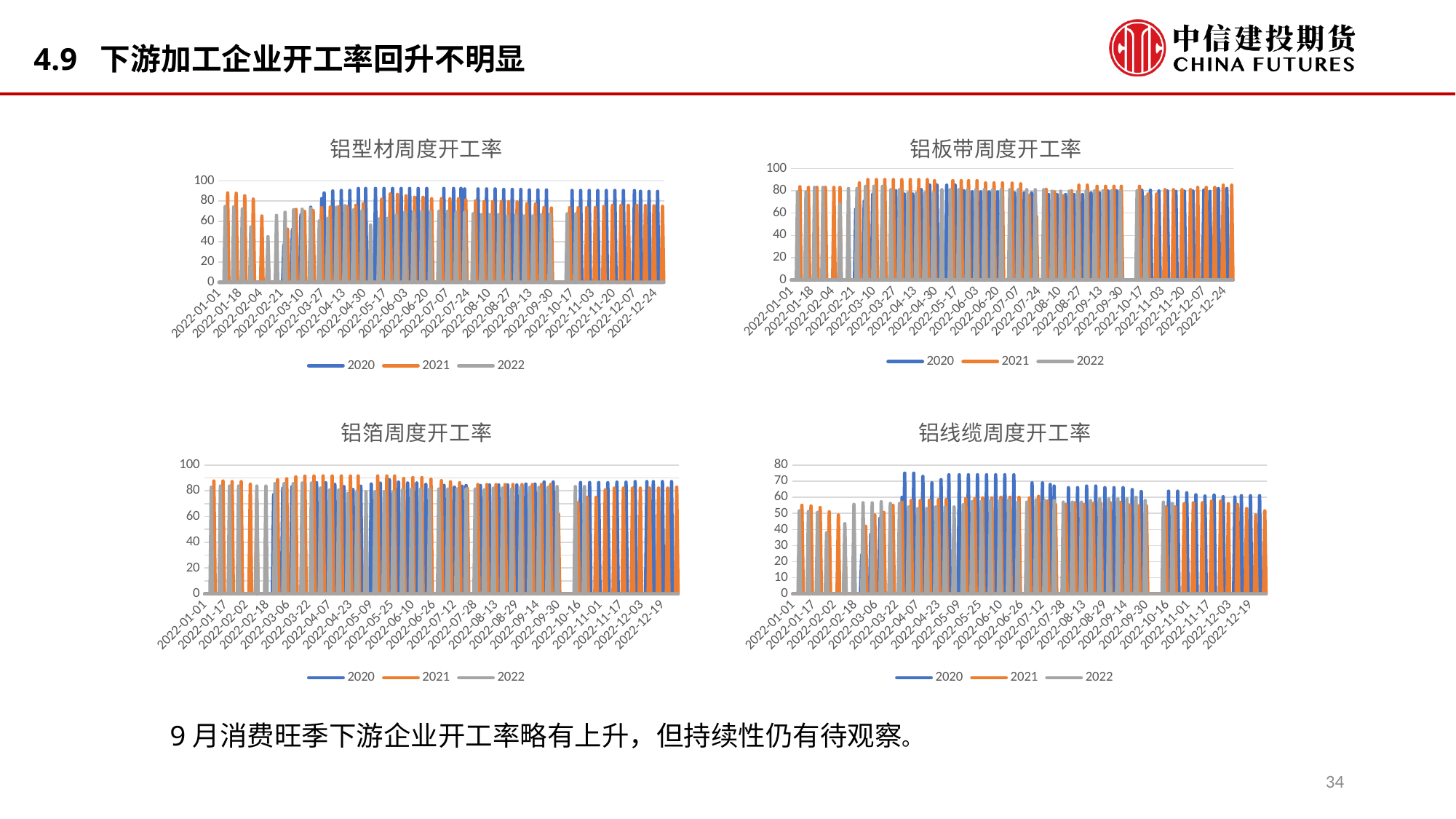
Which series is shown in orange in the 铝型材周度开工率 chart? 2021 How many series does the legend list in the 铝型材周度开工率 chart? 3 In the 铝线缆周度开工率 chart, is the highest 2020 value greater or less than 60? greater What is the title of the chart in the bottom-left of the slide? 铝箔周度开工率 What kind of chart is the 铝箔周度开工率 chart? line chart How many series does the legend list in the 铝线缆周度开工率 chart? 3 What kind of chart is the 铝线缆周度开工率 chart? line chart How many series does the legend list in the 铝箔周度开工率 chart? 3 What kind of chart is the 铝板带周度开工率 chart? line chart